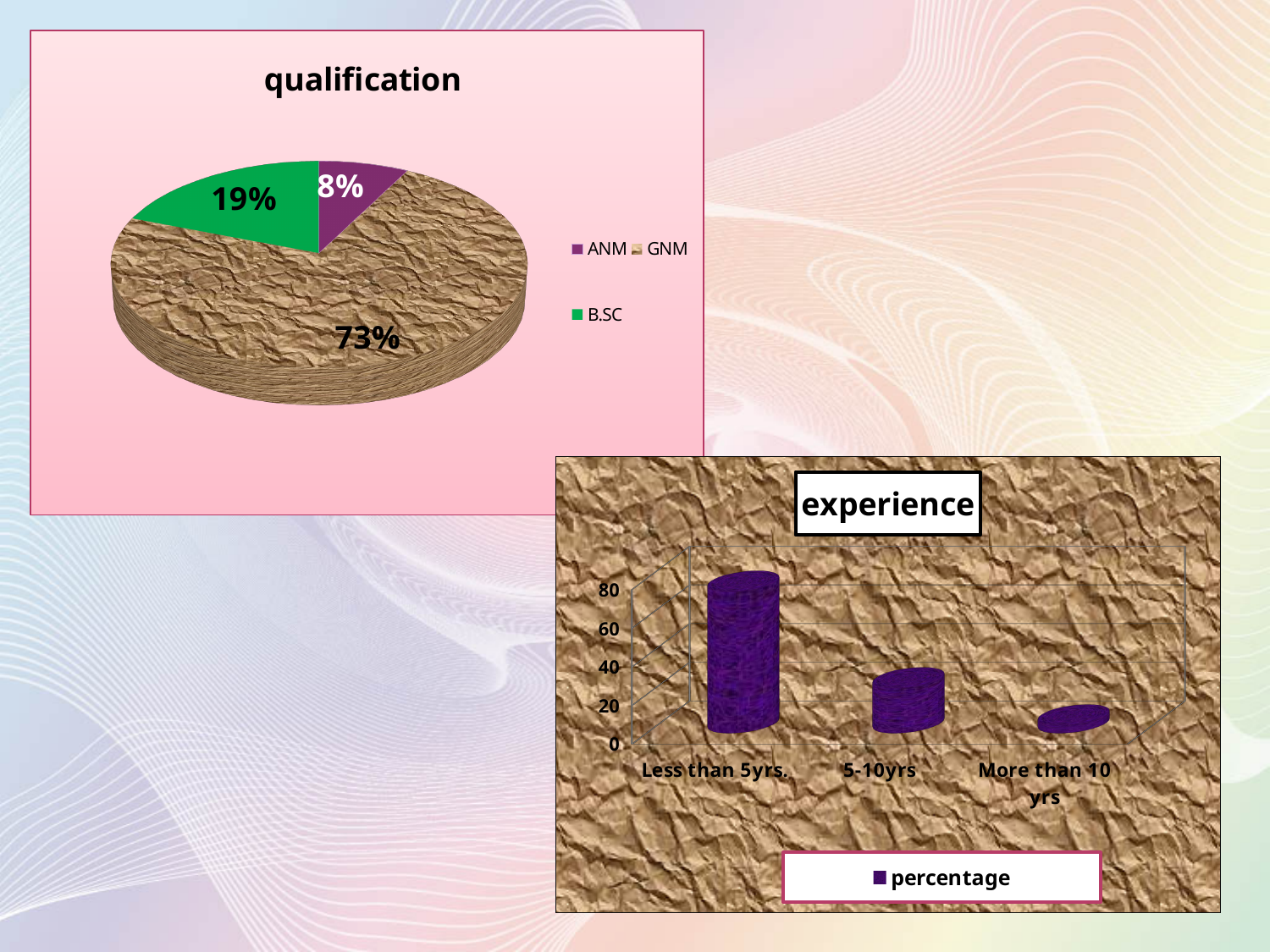
In the experience chart, is the value for Less than 5yrs. greater or less than 40? greater In the experience chart, what is the name of the series shown in the legend? percentage In the qualification pie chart, what is the difference between the GNM and B.SC shares? 54% In the qualification pie chart, what percentage is shown for ANM? 8% In the qualification pie chart, what percentage is shown for GNM? 73% In the experience chart, which category has the highest value? Less than 5yrs. In the qualification pie chart, how many categories does the legend list? 3 What type of chart is the experience chart? Bar chart In the experience chart, which category has the lowest value? More than 10 yrs In the qualification pie chart, what percentage is shown for B.SC? 19% In the qualification pie chart, which qualification has the smallest share? ANM In the qualification pie chart, which qualification has the largest share? GNM